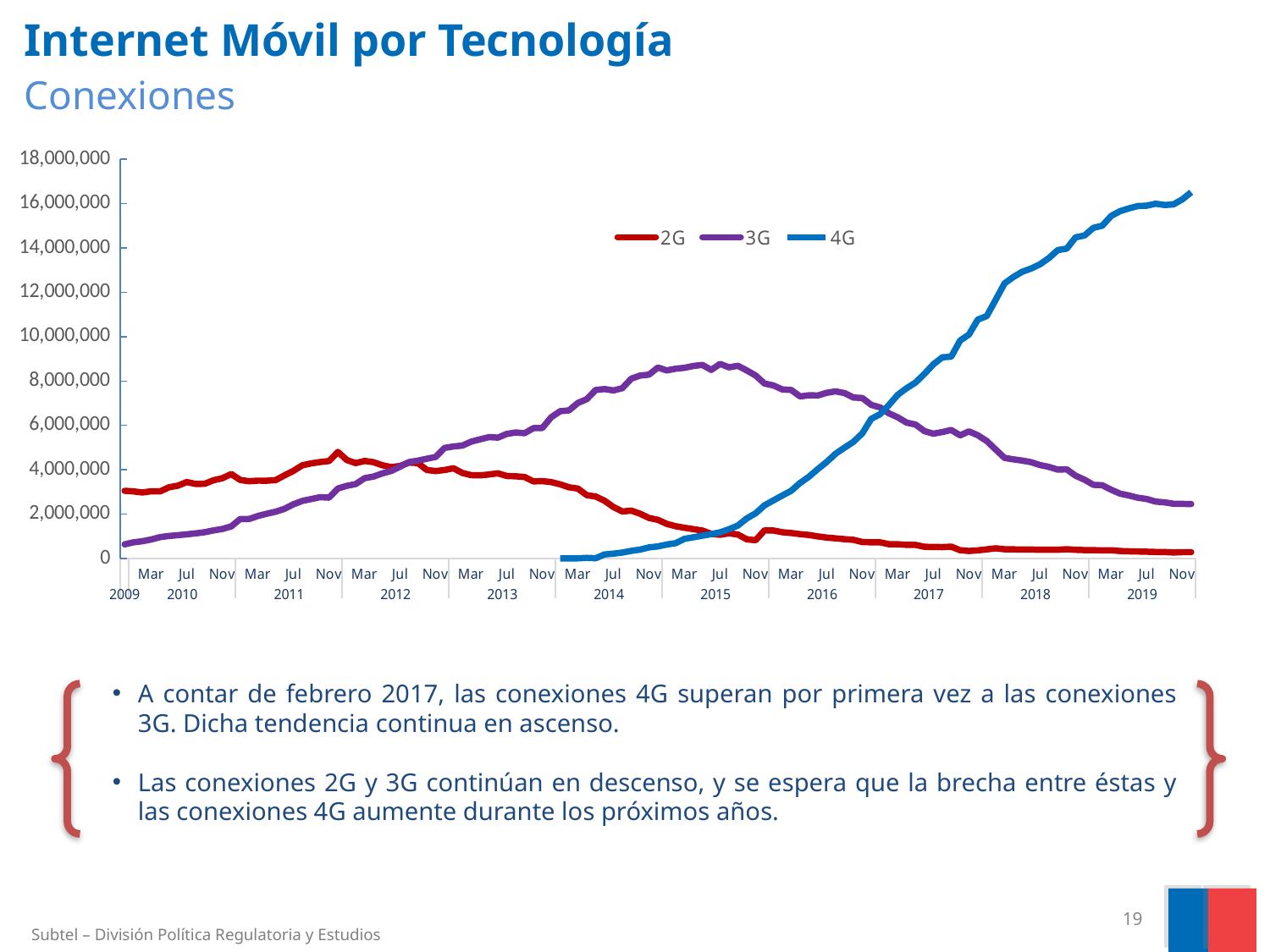
Which series has the lowest value in Nov 2019? 2G Is the value for 4G in Nov 2019 greater or less than 14,000,000? greater Does the 4G line rise or fall from 2014 to 2019? Rises Is the peak value of 3G in 2015 greater or less than 8,000,000? greater Which series has the highest value in Nov 2019? 4G How many series does the legend list? 3 What kind of chart is shown on the slide? Line chart Which series are listed in the legend? 2G, 3G, 4G Which is larger in 2009, 2G or 3G? 2G Is the value for 2G in Nov 2019 greater or less than 2,000,000? less Which is larger in Nov 2019, 3G or 4G? 4G What colour is the 4G line? Blue